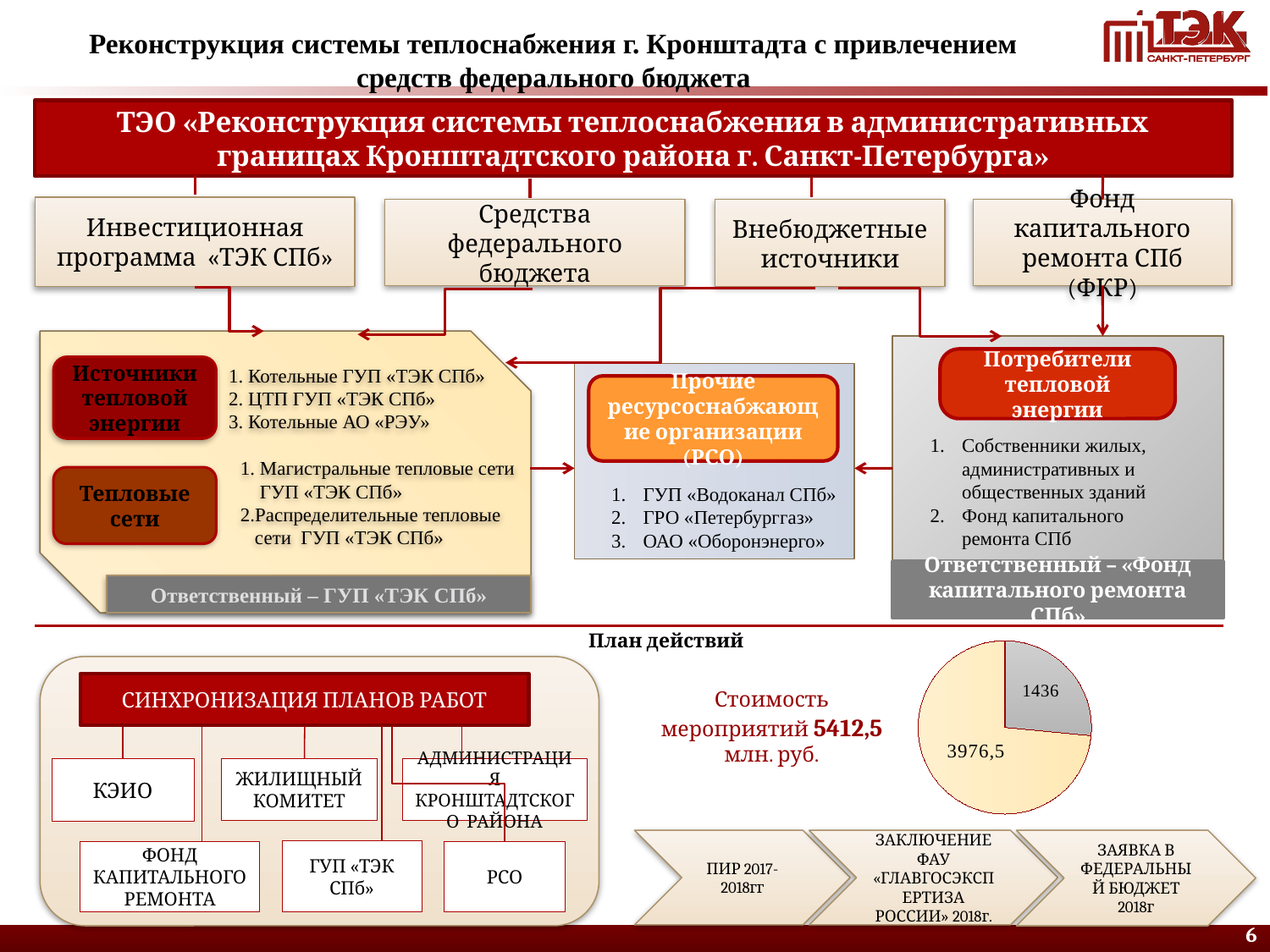
How many slices does the pie chart have? 2 What is the total of the two slices in the pie chart, as stated on the slide as the cost of measures? 5412,5 млн. руб. What is the difference between the two slice values in the pie chart (3976,5 and 1436)? 2540,5 What kind of chart is shown in the lower right of the slide? pie chart What is the value of the smallest slice of the pie chart? 1436 Which slice of the pie chart is larger, the one labelled 1436 or the one labelled 3976,5? 3976,5 What colour is the smaller slice (1436) of the pie chart? grey What is the value of the largest slice of the pie chart? 3976,5 What colour is the larger slice (3976,5) of the pie chart? light yellow